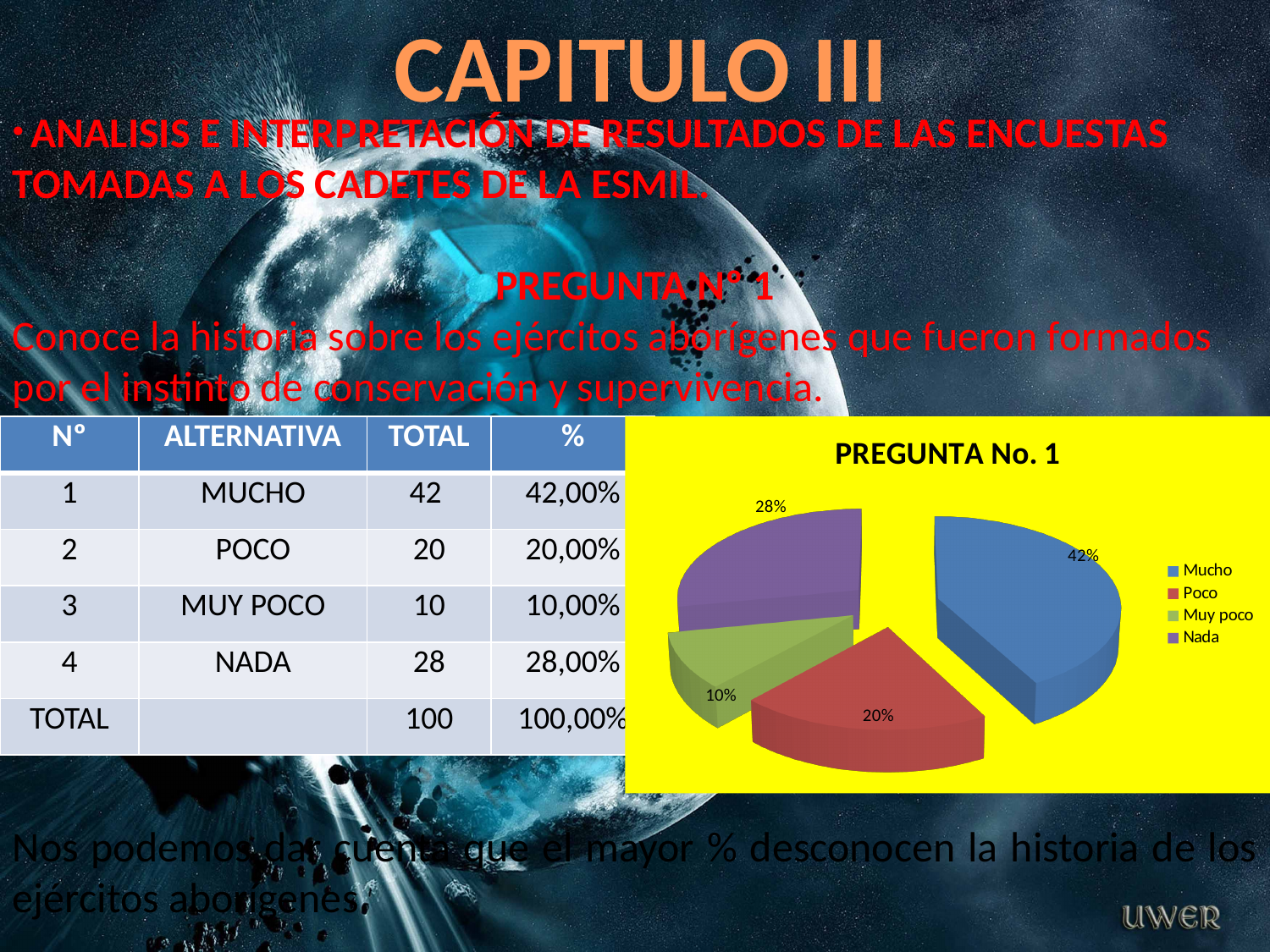
What is the title of the chart? PREGUNTA No. 1 Which slice is larger, Poco or Nada? Nada What percentage does the Poco slice show? 20% What percentage does the Nada slice show? 28% What is the difference in percentage points between the Mucho and Nada slices? 14 What kind of chart is shown on the slide? pie chart How many categories does the legend list? 4 Which category has the largest slice of the pie? Mucho Which category has the smallest slice of the pie? Muy poco What colour is the Mucho slice? blue What percentage does the Mucho slice show? 42% What percentage does the Muy poco slice show? 10%